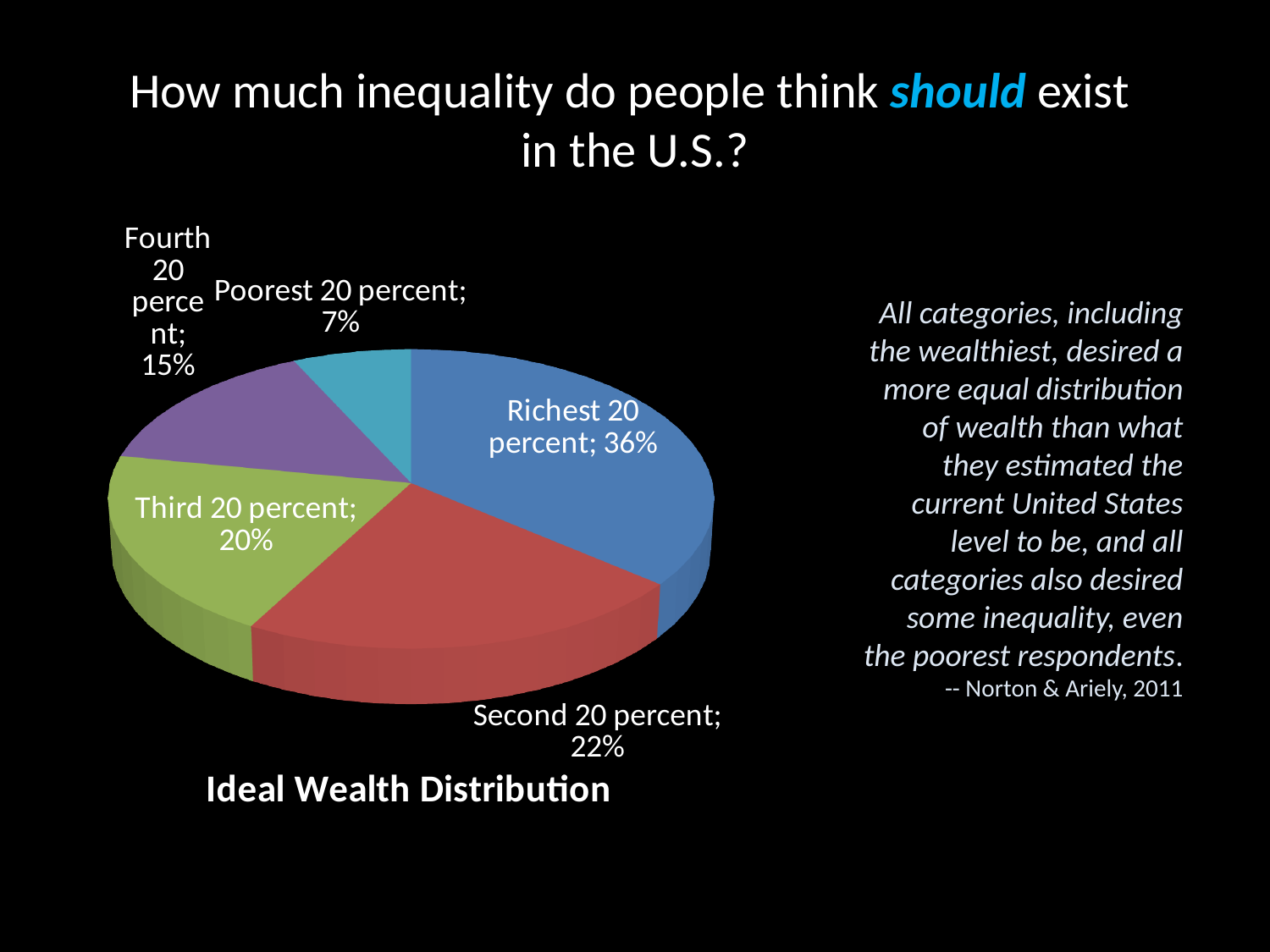
What is the difference between the shares for the Richest 20 percent and the Poorest 20 percent? 29% What share of the pie is labelled for the Third 20 percent? 20% What share of the pie is labelled for the Fourth 20 percent? 15% What share of the pie is labelled for the Poorest 20 percent? 7% How many slices does the pie chart have? 5 Which category has the smallest slice of the pie? Poorest 20 percent What kind of chart is shown on the slide? pie chart Which is larger, the share for the Second 20 percent or the Fourth 20 percent? Second 20 percent What is the title of the chart? Ideal Wealth Distribution Which category has the largest slice of the pie? Richest 20 percent What share of the pie is labelled for the Richest 20 percent? 36% What share of the pie is labelled for the Second 20 percent? 22%